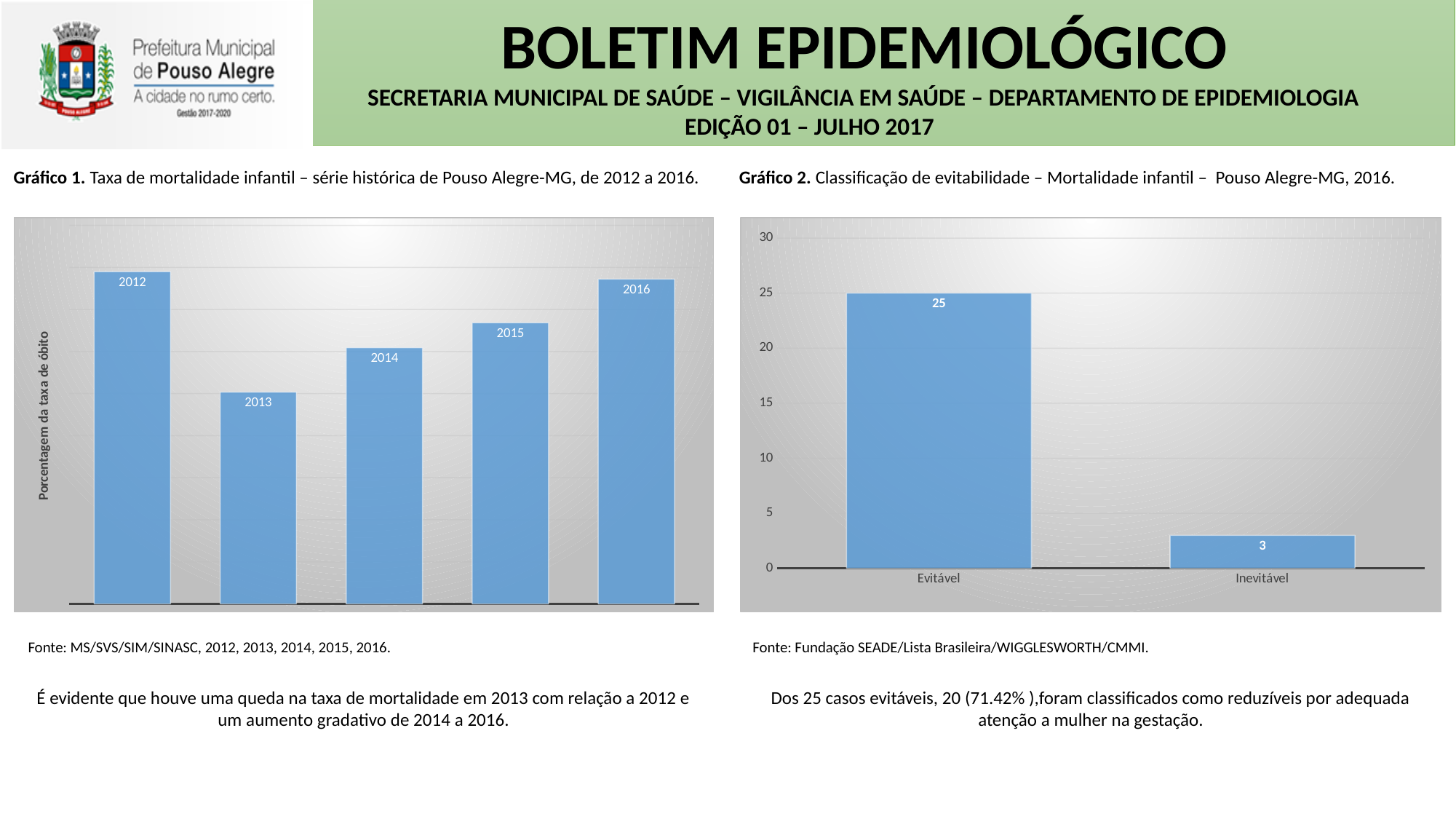
In Gráfico 2, which category has the highest value? Evitável In Gráfico 2, how many categories are shown on the x axis? 2 What kind of chart is Gráfico 1? bar chart In Gráfico 2, what is the value for Inevitável? 3 In Gráfico 1, do the values rise or fall from 2014 to 2016? rise In Gráfico 2, is the value for Inevitável greater or less than 5? less In Gráfico 2, what is the value for Evitável? 25 In Gráfico 2, what is the difference between the values for Evitável and Inevitável? 22 What is the y-axis label of Gráfico 1? Porcentagem da taxa de óbito In Gráfico 1, how many years are plotted? 5 In Gráfico 1, which year has the lowest infant mortality rate? 2013 In Gráfico 1, which is larger, the value for 2013 or the value for 2014? 2014